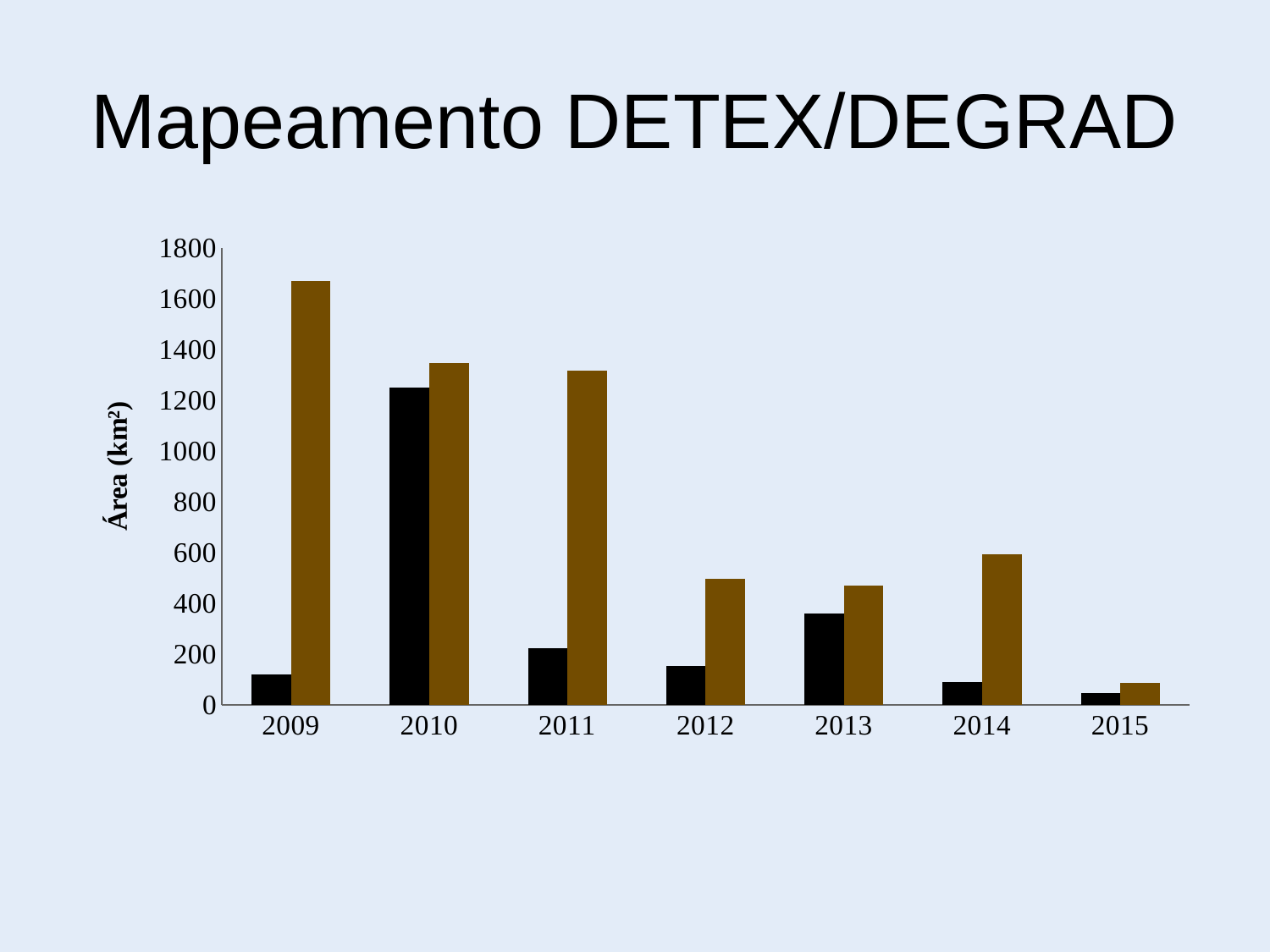
What is the label of the vertical axis of the chart? Área (km²) How many years are shown on the x axis of the chart? 7 In 2013, which bar is taller, the black bar or the brown bar? the brown bar Do the brown bars overall rise or fall from 2009 to 2015? fall Is the value of the brown bar for 2009 greater or less than 1600? greater In which year is the brown bar the highest? 2009 Is the value of the black bar for 2013 greater or less than 400? less What kind of chart is shown on the slide? bar chart What is the title of the slide containing the chart? Mapeamento DETEX/DEGRAD In which year is the black bar the highest? 2010 In which year is the brown bar the lowest? 2015 Is the value of the black bar for 2010 greater or less than 1200? greater